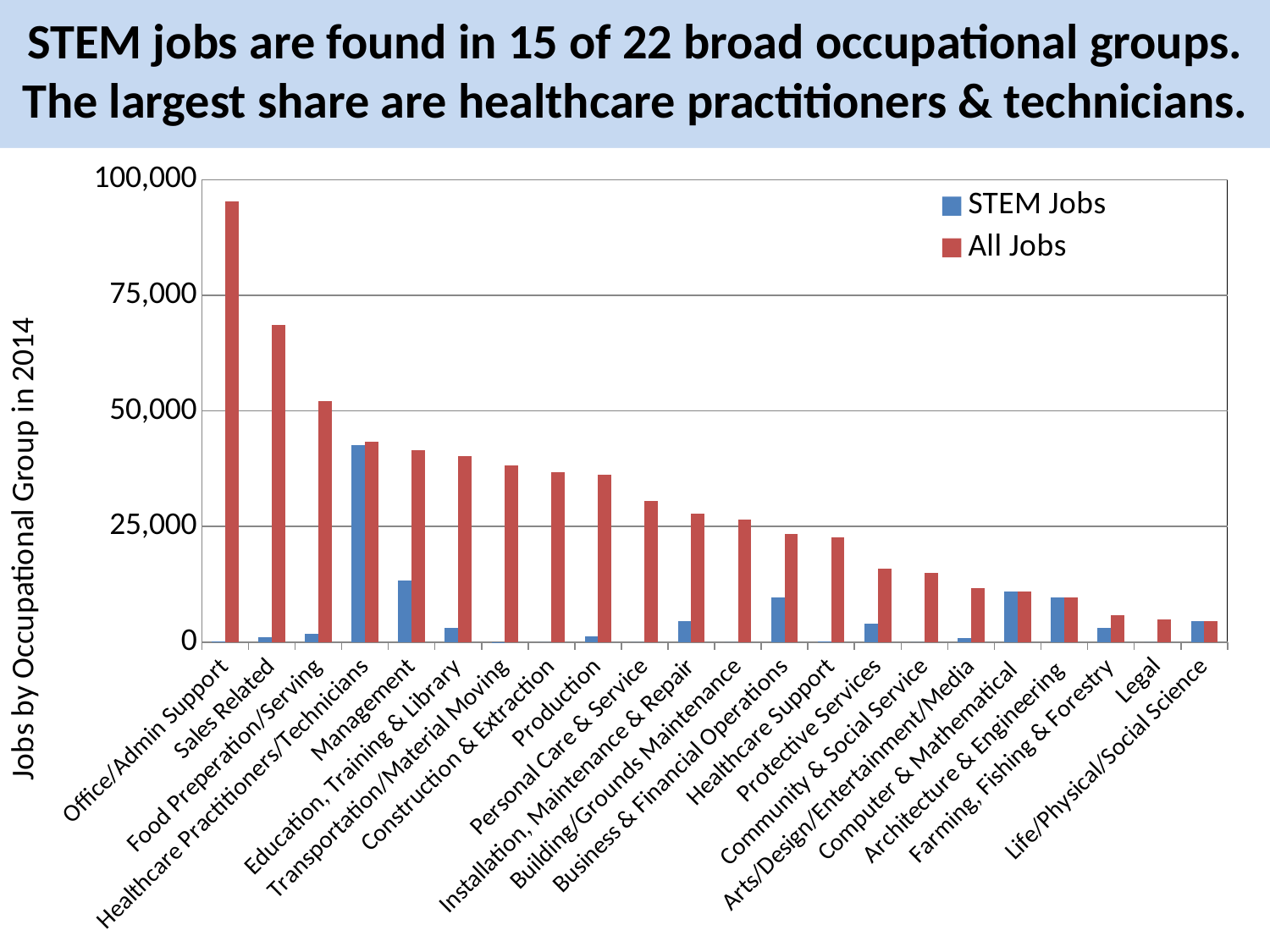
Is the All Jobs value for Office/Admin Support greater or less than 75,000? greater What is the title of the vertical axis? Jobs by Occupational Group in 2014 Is the STEM Jobs value for Healthcare Practitioners/Technicians greater or less than 25,000? greater Which occupational group has the highest value for STEM Jobs? Healthcare Practitioners/Technicians Which occupational group has the highest value for All Jobs? Office/Admin Support What kind of chart is shown on the slide? Bar chart How many occupational groups are plotted along the x axis? 22 Which has the larger STEM Jobs value, Healthcare Practitioners/Technicians or Business & Financial Operations? Healthcare Practitioners/Technicians Do the All Jobs values generally rise or fall moving from left to right along the x axis? fall Is the All Jobs value for Sales Related greater or less than 75,000? less How many series does the legend list? 2